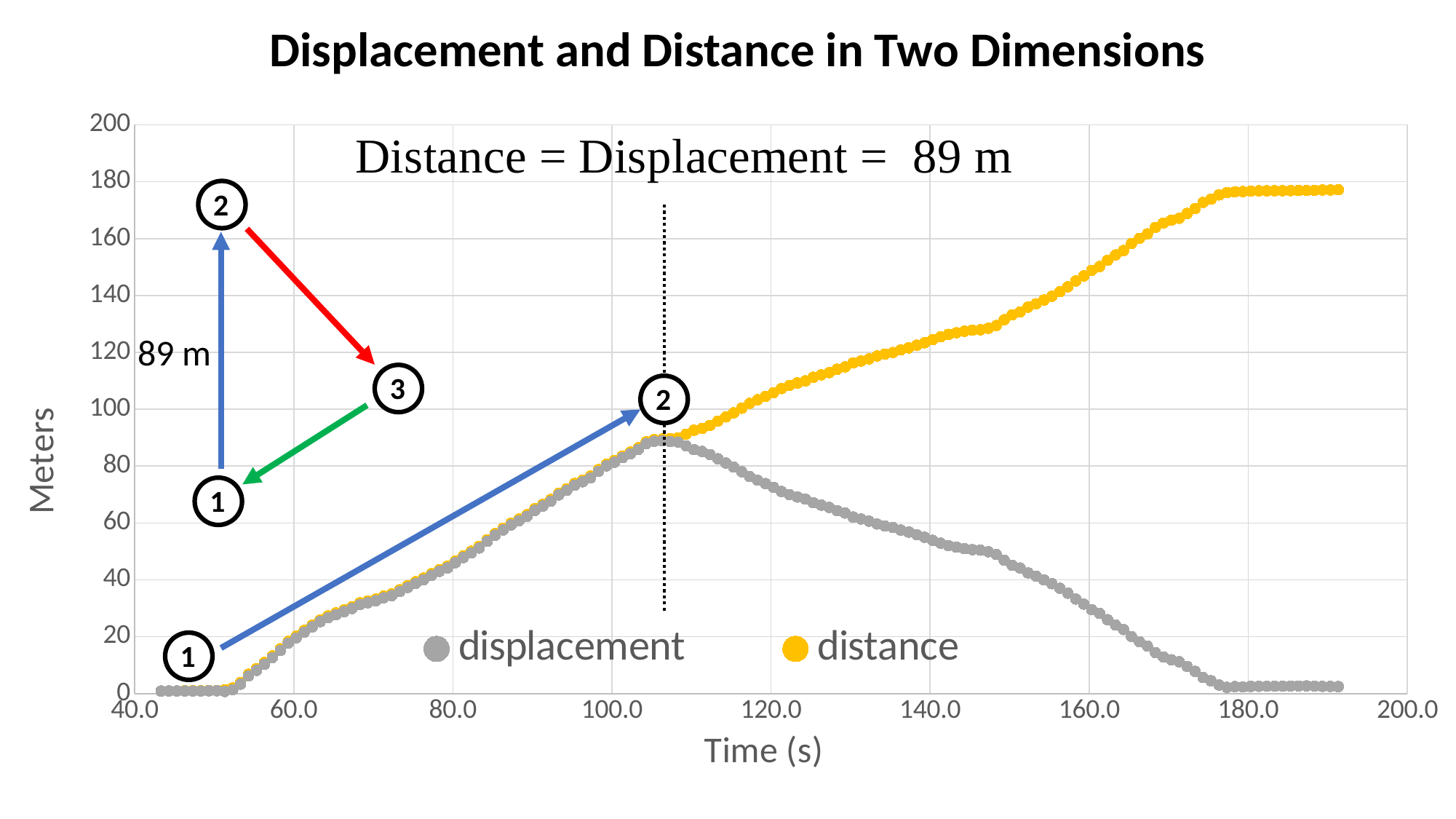
Does the displacement series rise or fall between 120.0 s and 170.0 s? fall How many series does the legend list? 2 Is the displacement value at 140.0 s greater or less than 80? less What are the two series named in the legend? displacement and distance What value do distance and displacement share at the point labelled 2, according to the annotation? 89 m Is the distance value at 140.0 s greater or less than 100? greater Is the distance value at 180.0 s greater or less than 160? greater What is the label of the x axis? Time (s) Does the distance series rise or fall between 60.0 s and 160.0 s? rise At 160.0 s, which series has the larger value, displacement or distance? distance What is the title of the chart? Displacement and Distance in Two Dimensions